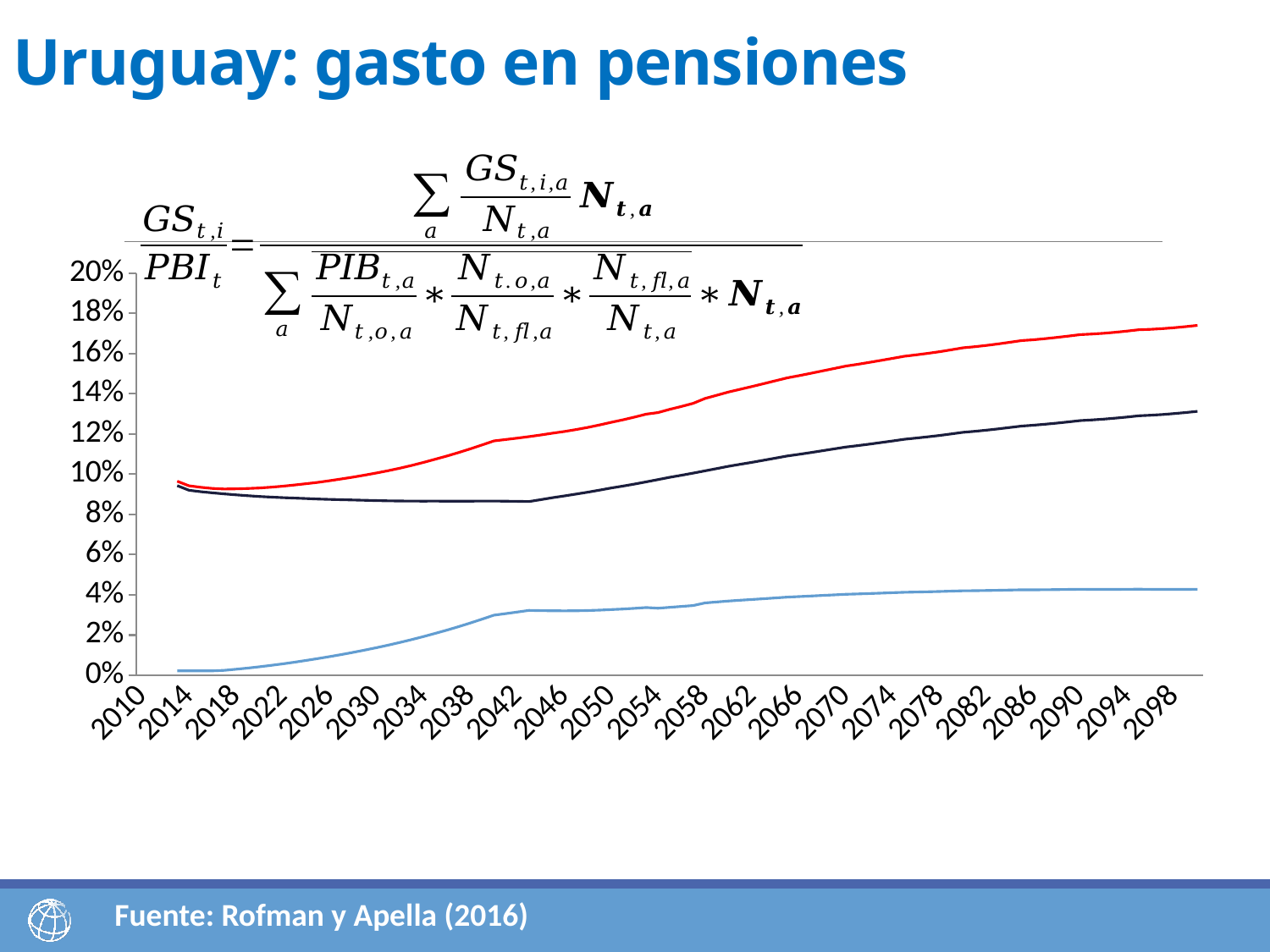
At 2098, which is larger: the red line or the dark navy line? the red line How many lines are plotted on the chart? 3 Is the value of the light blue line at 2098 greater or less than 6%? less What kind of chart is shown on the slide? line chart Which line is lowest across the whole chart? the light blue line What is the title of the slide containing the chart? Uruguay: gasto en pensiones Is the value of the dark navy line at 2098 greater or less than 12%? greater How many year labels are shown along the x axis of the chart? 23 Which line is highest at the right end of the chart (2098)? the red line Does the red line rise or fall from 2014 to 2098? rises Is the value of the red line at 2098 greater or less than 16%? greater